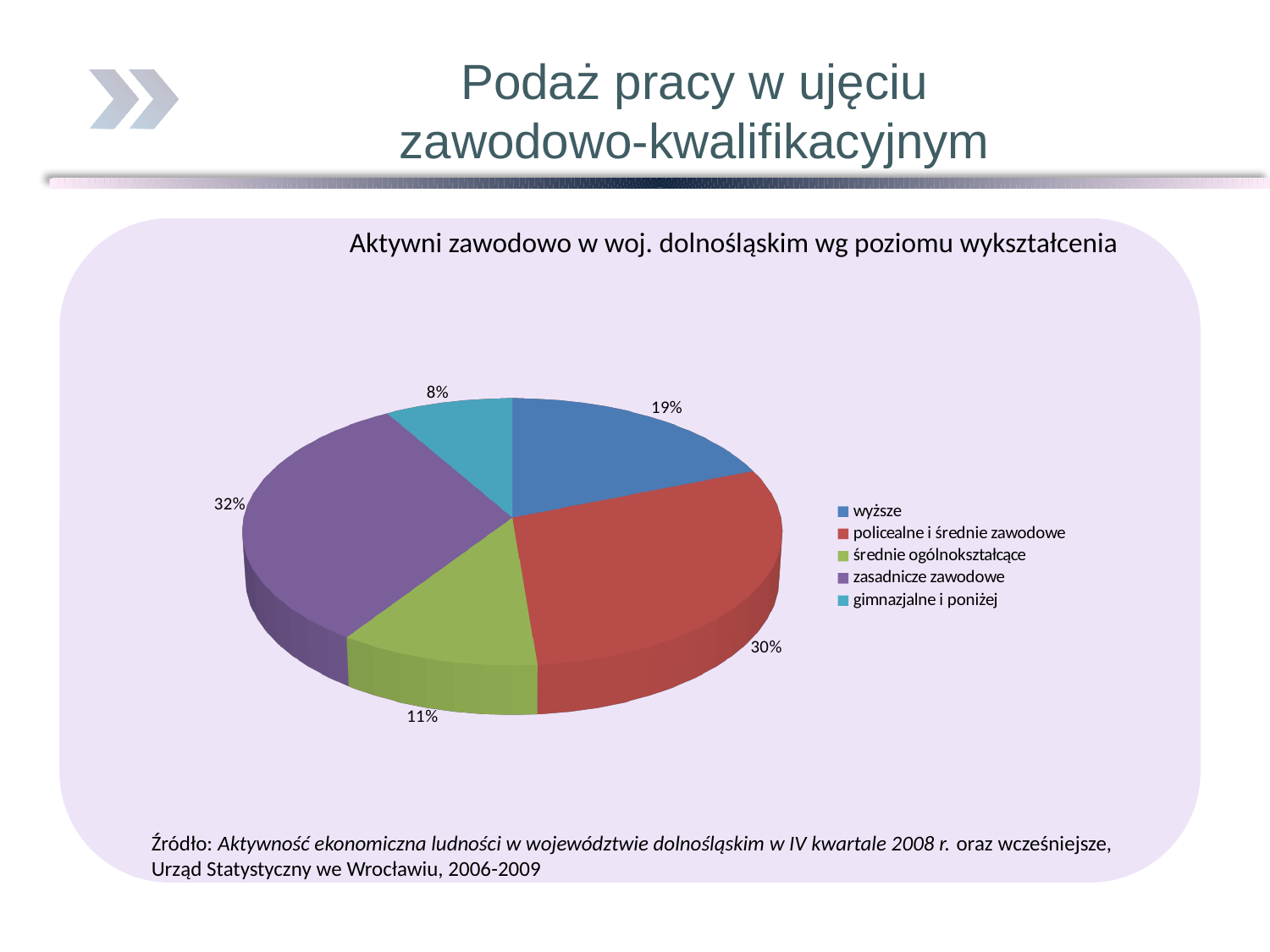
What share of the pie is labelled for 'średnie ogólnokształcące'? 11% What is the difference between the shares for 'zasadnicze zawodowe' and 'wyższe'? 13% What is the title of the chart? Aktywni zawodowo w woj. dolnośląskim wg poziomu wykształcenia What share of the pie is labelled for 'wyższe'? 19% Which category has the largest share of the pie? zasadnicze zawodowe Which is larger, the share for 'wyższe' or the share for 'średnie ogólnokształcące'? wyższe What share of the pie is labelled for 'policealne i średnie zawodowe'? 30% How many categories does the pie chart show? 5 What kind of chart is shown on the slide? pie chart Which category has the smallest share of the pie? gimnazjalne i poniżej